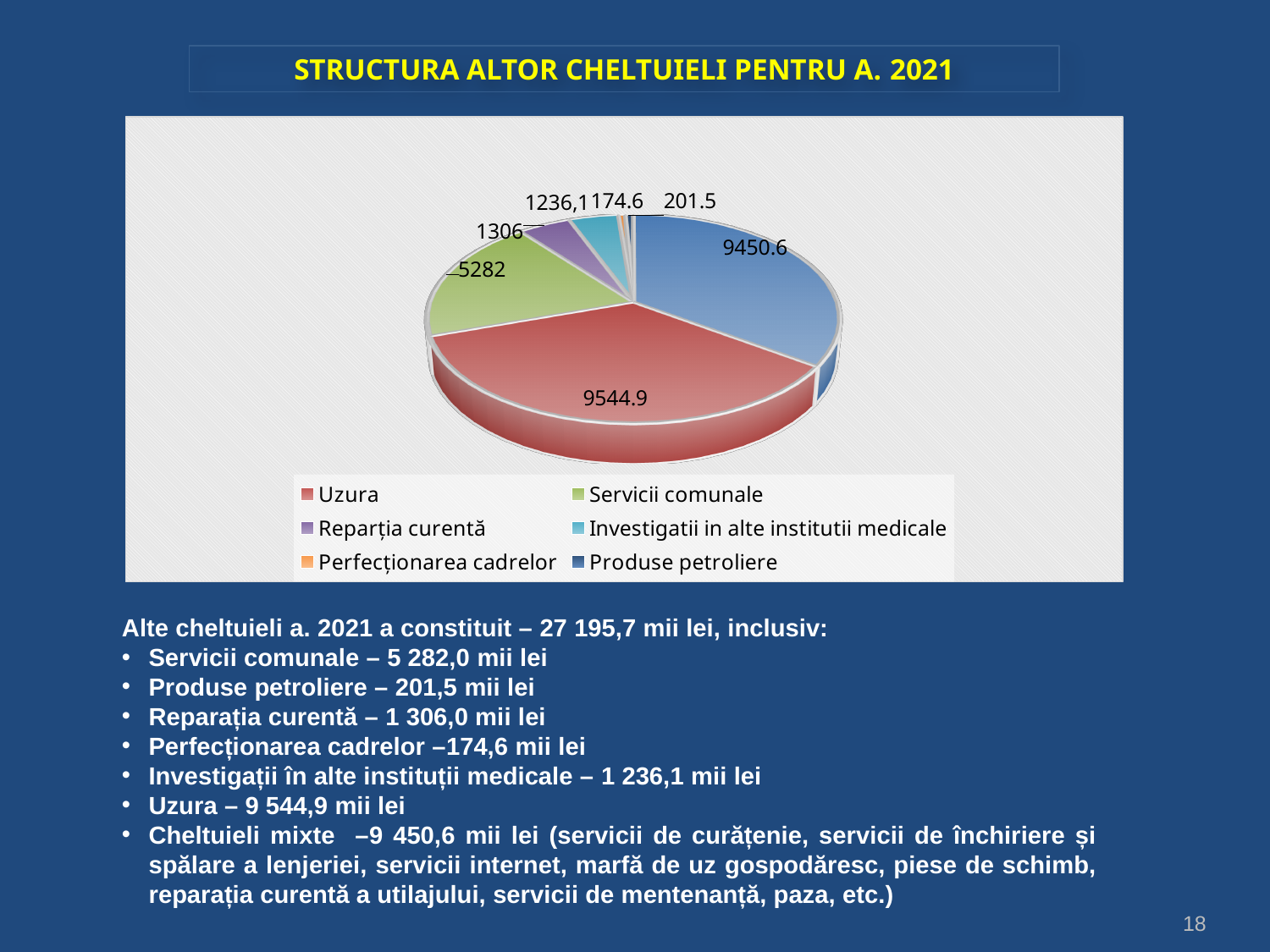
What is the value shown for Perfecționarea cadrelor in the pie chart? 174.6 Which category has the smallest slice in the pie chart? Perfecționarea cadrelor What is the title of the chart on the slide? STRUCTURA ALTOR CHELTUIELI PENTRU A. 2021 How many entries does the chart legend list? 6 What is the difference between the values for Uzura and Servicii comunale? 4262.9 What is the value shown for Reparția curentă in the pie chart? 1306 What is the value shown for Uzura in the pie chart? 9544.9 How many slices with data labels does the pie chart have? 7 What is the value shown for Servicii comunale in the pie chart? 5282 Which category has the largest slice in the pie chart? Uzura Which is larger, the value for Reparția curentă or the value for Investigatii in alte institutii medicale? Reparția curentă What kind of chart is shown on the slide? pie chart